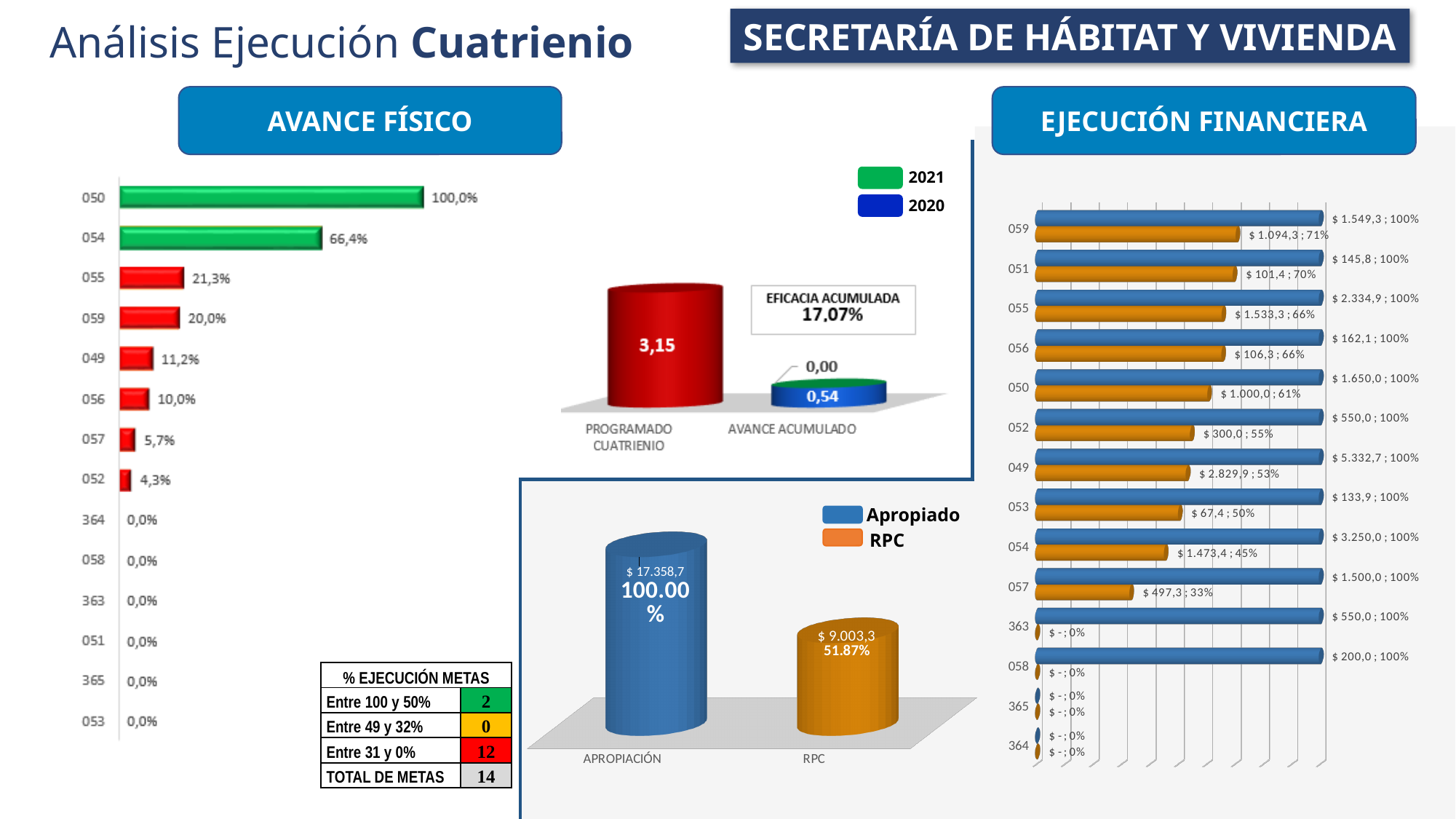
In the APROPIACIÓN / RPC chart at the bottom centre, what is the value for RPC? $ 9.003,3 In the AVANCE FÍSICO bar chart on the left, which is larger, the value for 049 or the value for 056? 049 In the AVANCE FÍSICO bar chart on the left, what is the difference between the values for 055 and 059? 1,3% In the PROGRAMADO CUATRIENIO / AVANCE ACUMULADO chart in the centre, what is the value for PROGRAMADO CUATRIENIO? 3,15 In the AVANCE FÍSICO bar chart on the left, how many categories are shown? 14 In the APROPIACIÓN / RPC chart at the bottom centre, what percentage is shown for RPC? 51.87% In the PROGRAMADO CUATRIENIO / AVANCE ACUMULADO chart in the centre, what is the EFICACIA ACUMULADA shown? 17,07% In the AVANCE FÍSICO bar chart on the left, which category has the highest value? 050 In the EJECUCIÓN FINANCIERA chart on the right, how many series does the legend list? 2 In the AVANCE FÍSICO bar chart on the left, what is the value for category 054? 66,4% In the EJECUCIÓN FINANCIERA chart on the right, what RPC percentage is shown for category 057? 33% In the EJECUCIÓN FINANCIERA chart on the right, what is the RPC value for category 049? $ 2.829,9